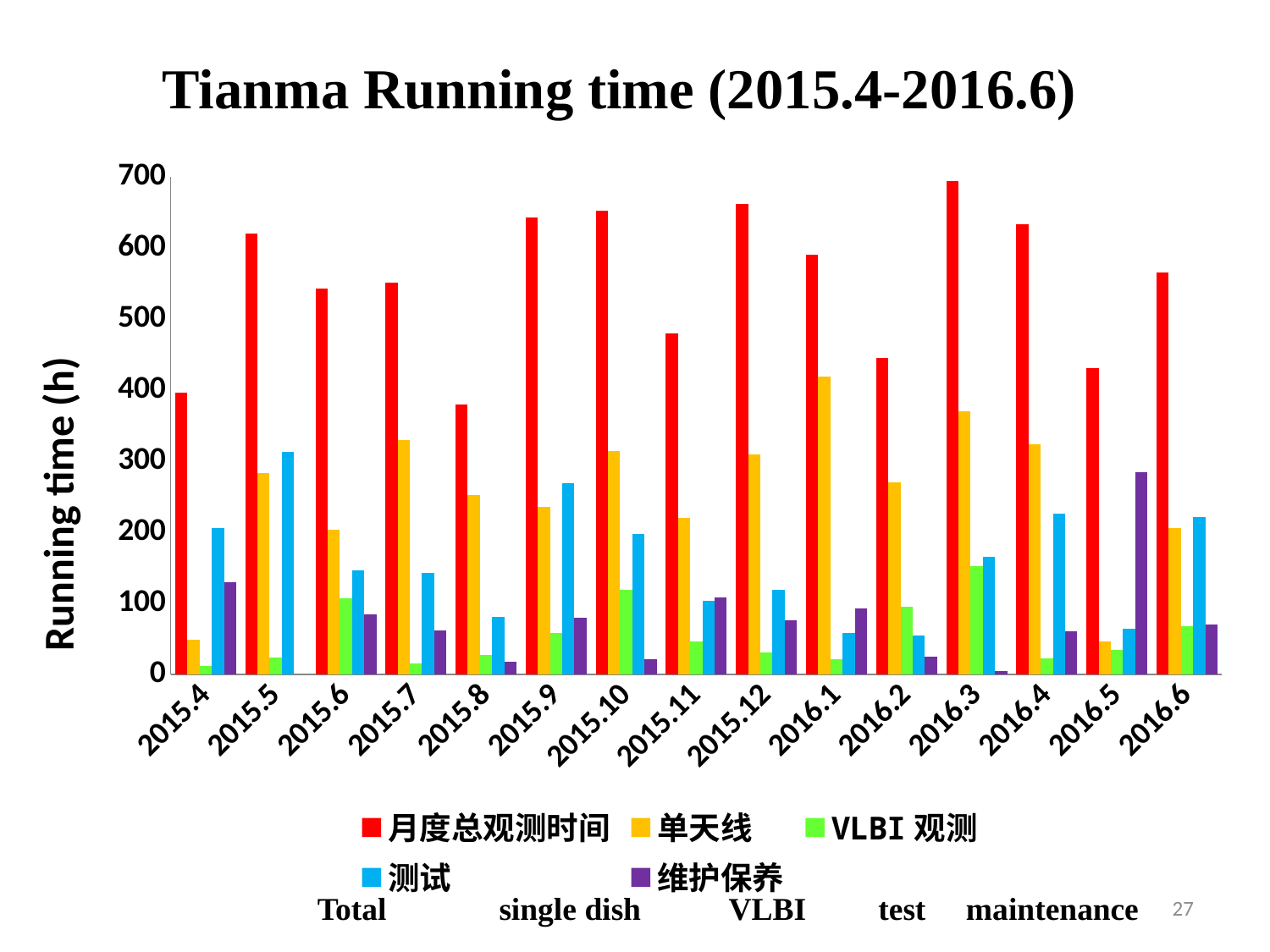
Which month has the highest maintenance value (purple bars)? 2016.5 Which month has the highest single dish value (orange bars)? 2016.1 Which month has the larger monthly total observation time, 2015.5 or 2015.6? 2015.5 Is the maintenance value for 2016.5 greater or less than 200? greater Which month has the highest test value (blue bars)? 2015.5 Is the monthly total observation time for 2016.3 greater or less than 600? greater What is the title of the y axis? Running time (h) How many months (categories) are shown on the x axis? 15 Is the monthly total observation time for 2015.11 greater or less than 500? less What kind of chart is shown on the slide? bar chart How many series does the legend list? 5